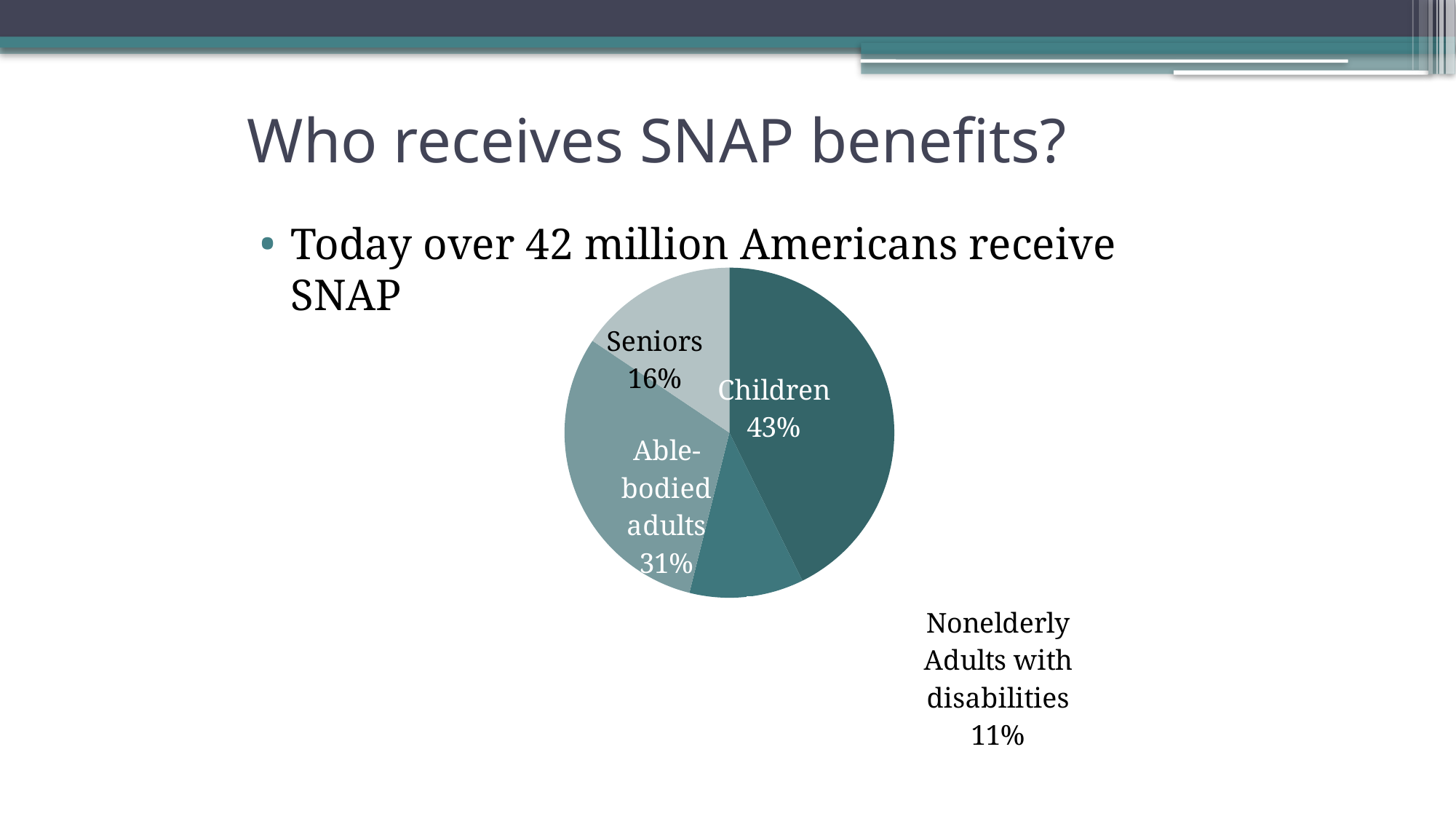
What share of SNAP recipients are Able-bodied adults? 31% What is the difference in percentage points between Seniors and Nonelderly Adults with disabilities? 5 What is the title of the slide containing the pie chart? Who receives SNAP benefits? What kind of chart is shown on the slide? pie chart What share of SNAP recipients are Seniors? 16% Which group has the smallest slice of the pie? Nonelderly Adults with disabilities What is the difference in percentage points between Children and Able-bodied adults? 12 How many slices does the pie chart have? 4 Which is larger, the share for Seniors or the share for Able-bodied adults? Able-bodied adults What share of SNAP recipients are Children? 43% What share of SNAP recipients are Nonelderly Adults with disabilities? 11% Which group has the largest slice of the pie? Children